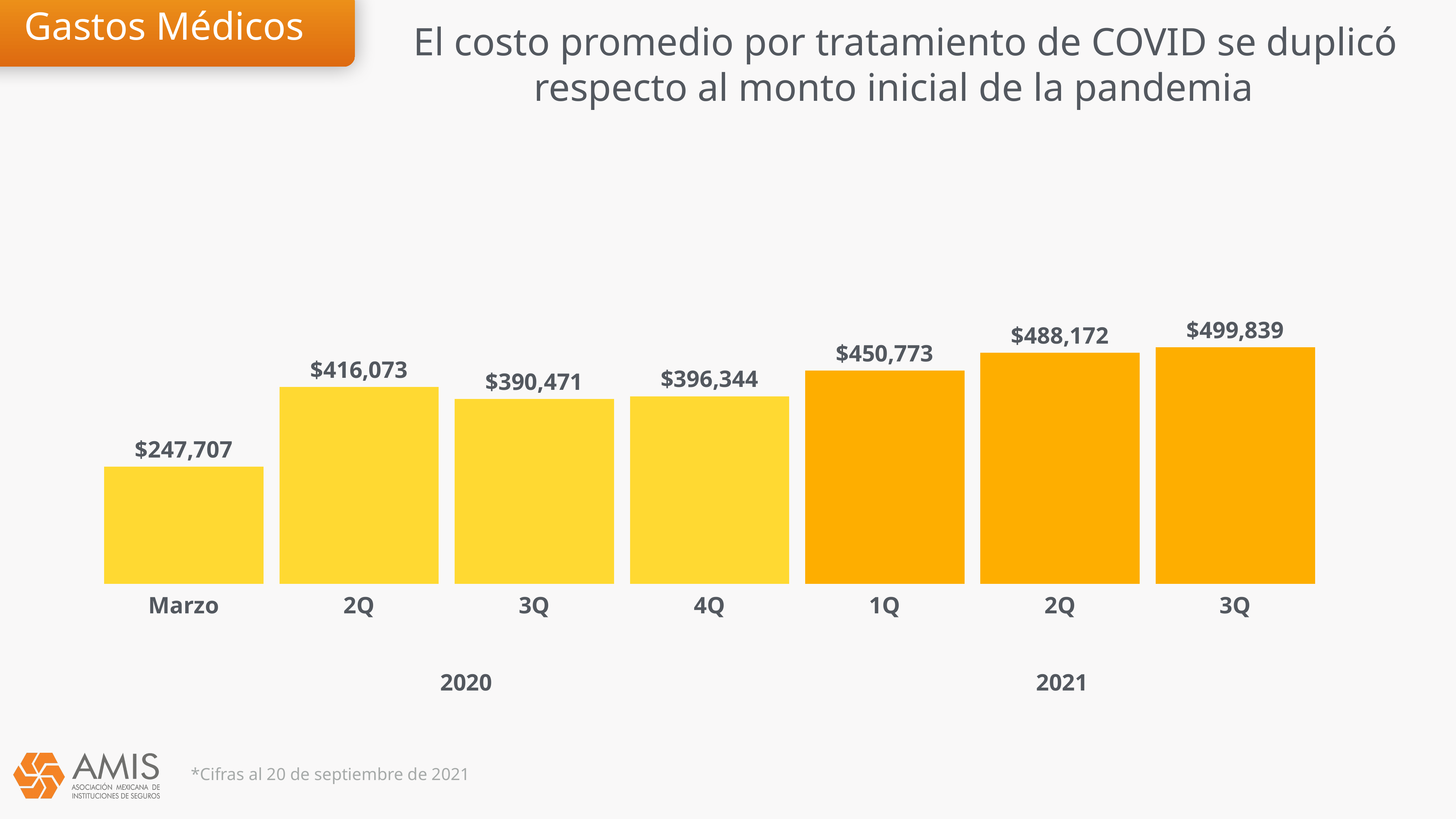
Which period has the lowest average cost? Marzo 2020 What is the value shown for 4Q 2020? $396,344 What is the value shown for 1Q 2021? $450,773 How many bars are shown in the chart? 7 What is the difference between the value for 3Q 2021 and the value for Marzo 2020? $252,132 What is the value shown for 3Q 2021? $499,839 What is the average COVID treatment cost shown for Marzo 2020? $247,707 What kind of chart is shown on the slide? Bar chart What is the difference between the value for 2Q 2021 and the value for 1Q 2021? $37,399 Which period has the highest average cost? 3Q 2021 Which year's bars are shown in the darker orange colour? 2021 Which is larger, the value for 2Q 2020 or the value for 3Q 2020? 2Q 2020